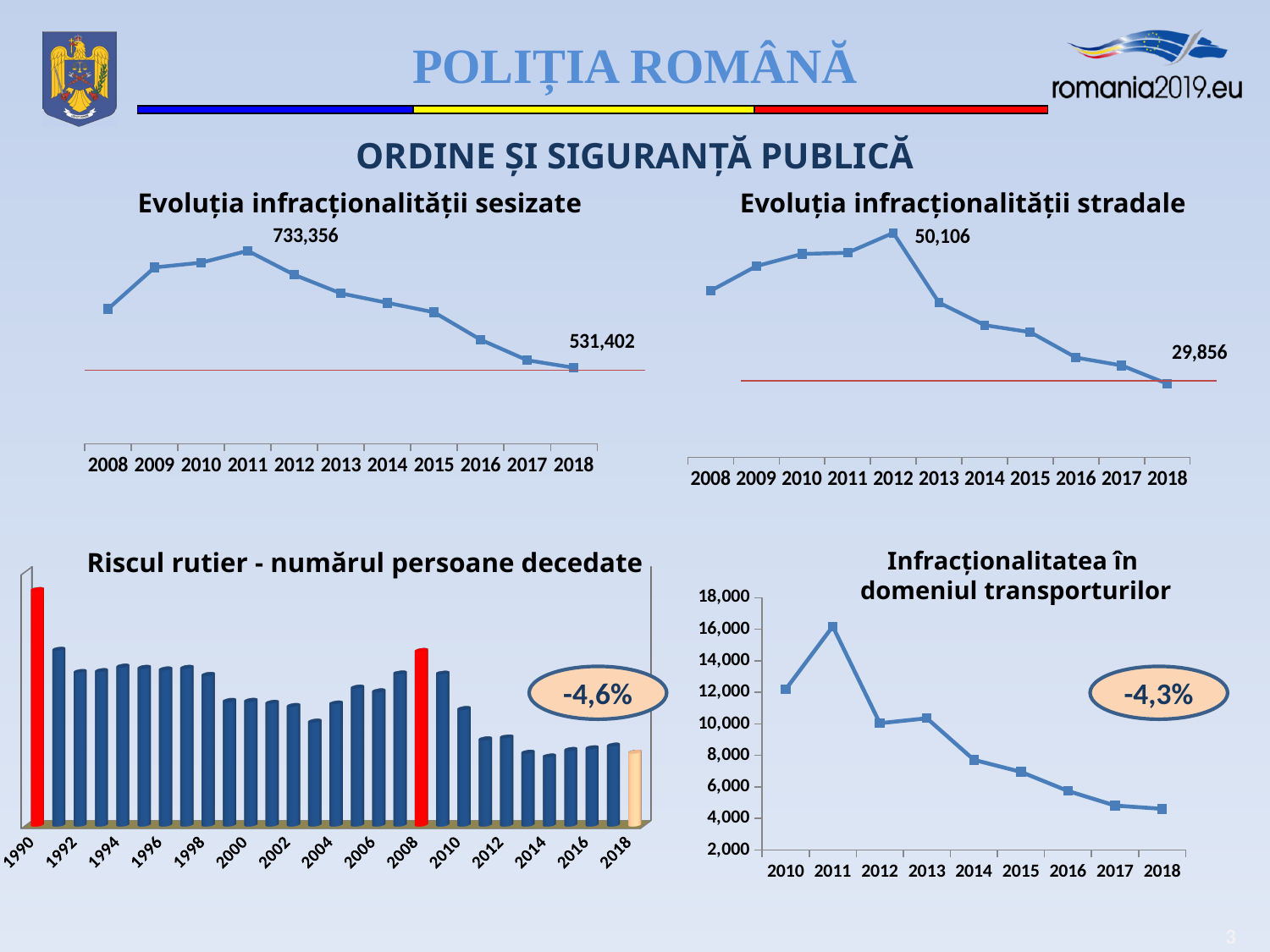
In the chart 'Evoluția infracționalității sesizate', what is the difference between the 2011 value and the 2018 value? 201,954 In the chart 'Evoluția infracționalității stradale', what is the difference between the 2012 value and the 2018 value? 20,250 What kind of chart is 'Riscul rutier - numărul persoane decedate'? bar chart In the chart 'Evoluția infracționalității sesizate', what value is labelled for 2011? 733,356 In the chart 'Evoluția infracționalității stradale', which year has the lowest value? 2018 In the chart 'Evoluția infracționalității sesizate', what value is labelled for 2018? 531,402 In the chart 'Evoluția infracționalității stradale', what value is labelled for 2018? 29,856 In the chart 'Infracționalitatea în domeniul transporturilor', do the values rise or fall from 2013 to 2018? fall In the chart 'Infracționalitatea în domeniul transporturilor', how many data points are plotted? 9 In the chart 'Evoluția infracționalității sesizate', which year has the highest value? 2011 In the chart 'Infracționalitatea în domeniul transporturilor', is the value for 2011 greater or less than 14,000? greater In the chart 'Evoluția infracționalității stradale', what value is labelled for 2012? 50,106